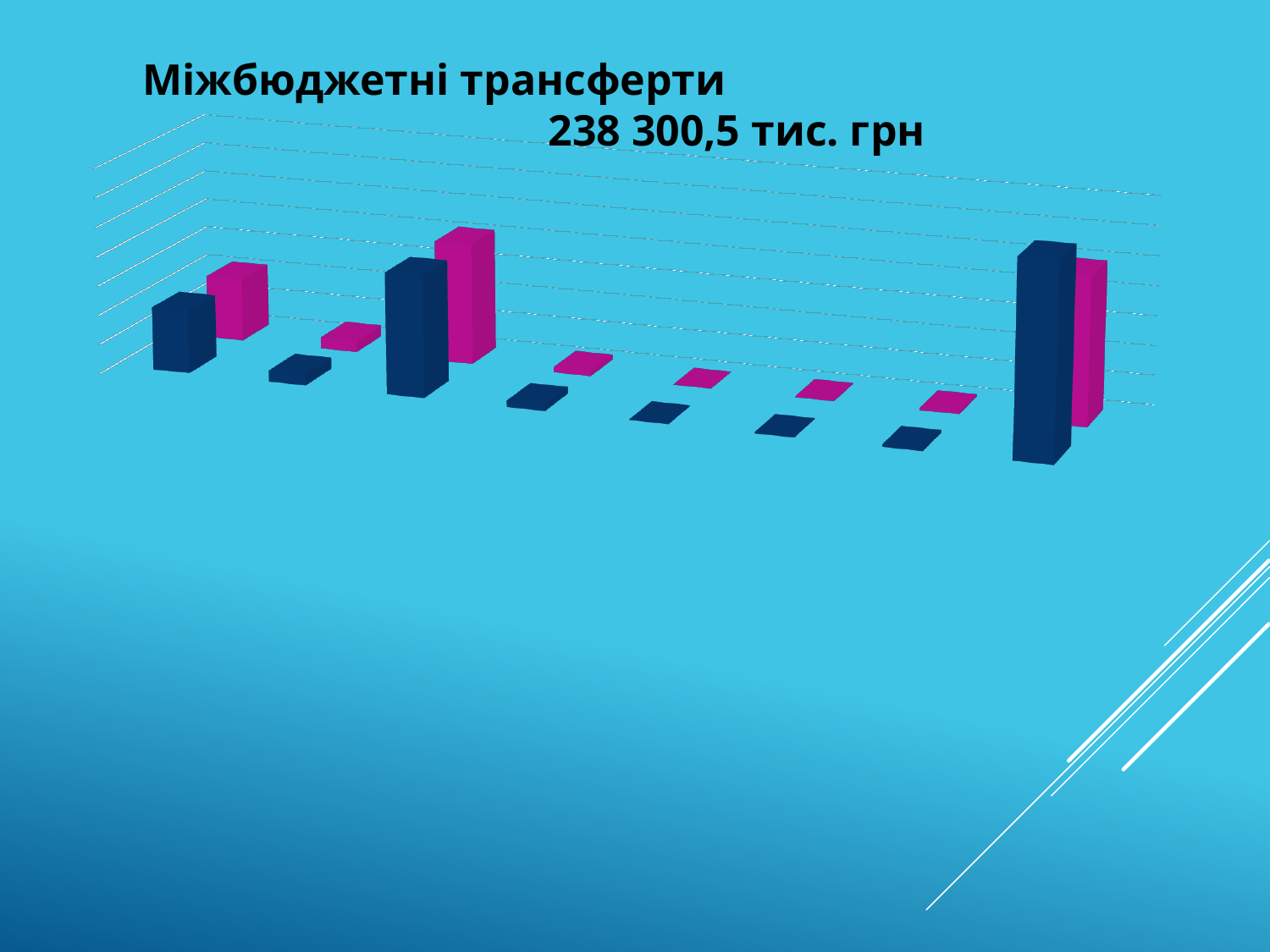
How many differently coloured bar series are plotted in the chart? 2 In the rightmost group of bars, which bar is taller: the dark blue one or the magenta one? the dark blue one What is the title of the chart? Міжбюджетні трансферти 238 300,5 тис. грн How many groups of bars are plotted in the chart? 8 Which group of bars, by position from left, has the tallest bar in the chart? the rightmost (8th) group What kind of chart is shown on the slide? bar chart What total amount is stated in the chart title? 238 300,5 тис. грн In the first (leftmost) group of bars, which bar is taller: the dark blue one or the magenta one? Neither; they are the same height